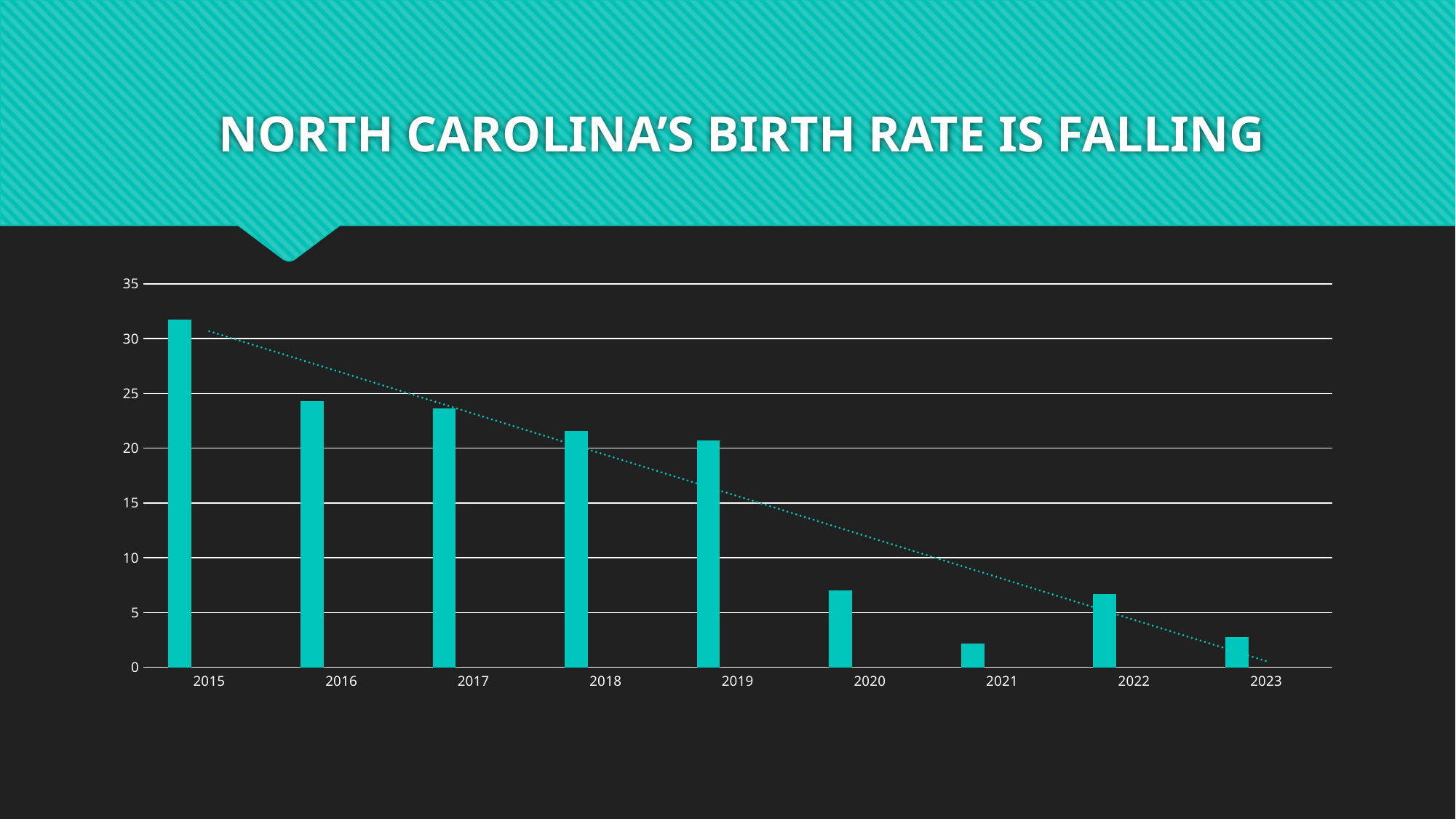
What is the title of the slide containing the chart? North Carolina's Birth Rate Is Falling Is the value for 2015 greater or less than 30? greater Do the values generally rise or fall from 2015 to 2023? Fall How many years are shown on the x axis of the chart? 9 Which is larger, the value for 2019 or the value for 2020? 2019 Which year has the highest bar in the chart? 2015 Is the value for 2020 greater or less than 5? greater Is the value for 2023 greater or less than 5? less What kind of chart is shown on the slide? Bar chart